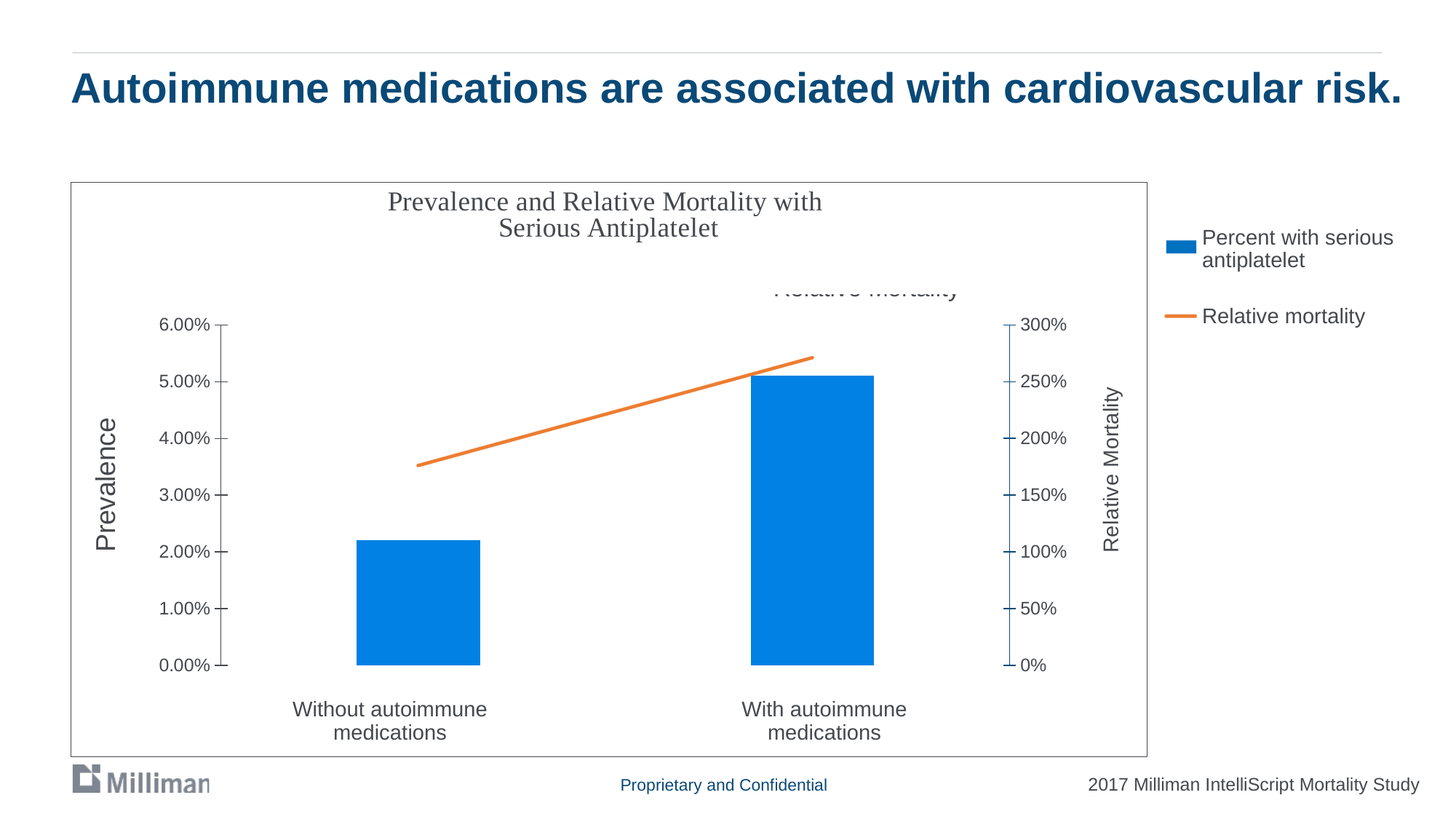
Is the percent with serious antiplatelet for 'With autoimmune medications' greater or less than 4.00%? greater Does relative mortality rise or fall from 'Without autoimmune medications' to 'With autoimmune medications'? rise Which category has the higher percent with serious antiplatelet? With autoimmune medications How many series does the legend list? 2 Is the relative mortality for 'With autoimmune medications' greater or less than 250%? greater How many categories are shown on the x axis? 2 Is the percent with serious antiplatelet for 'Without autoimmune medications' greater or less than 3.00%? less What is the title of the chart? Prevalence and Relative Mortality with Serious Antiplatelet What is the title of the right-hand vertical axis? Relative Mortality What kind of chart is shown on the slide? A bar chart with a line series Which category has the lower percent with serious antiplatelet? Without autoimmune medications